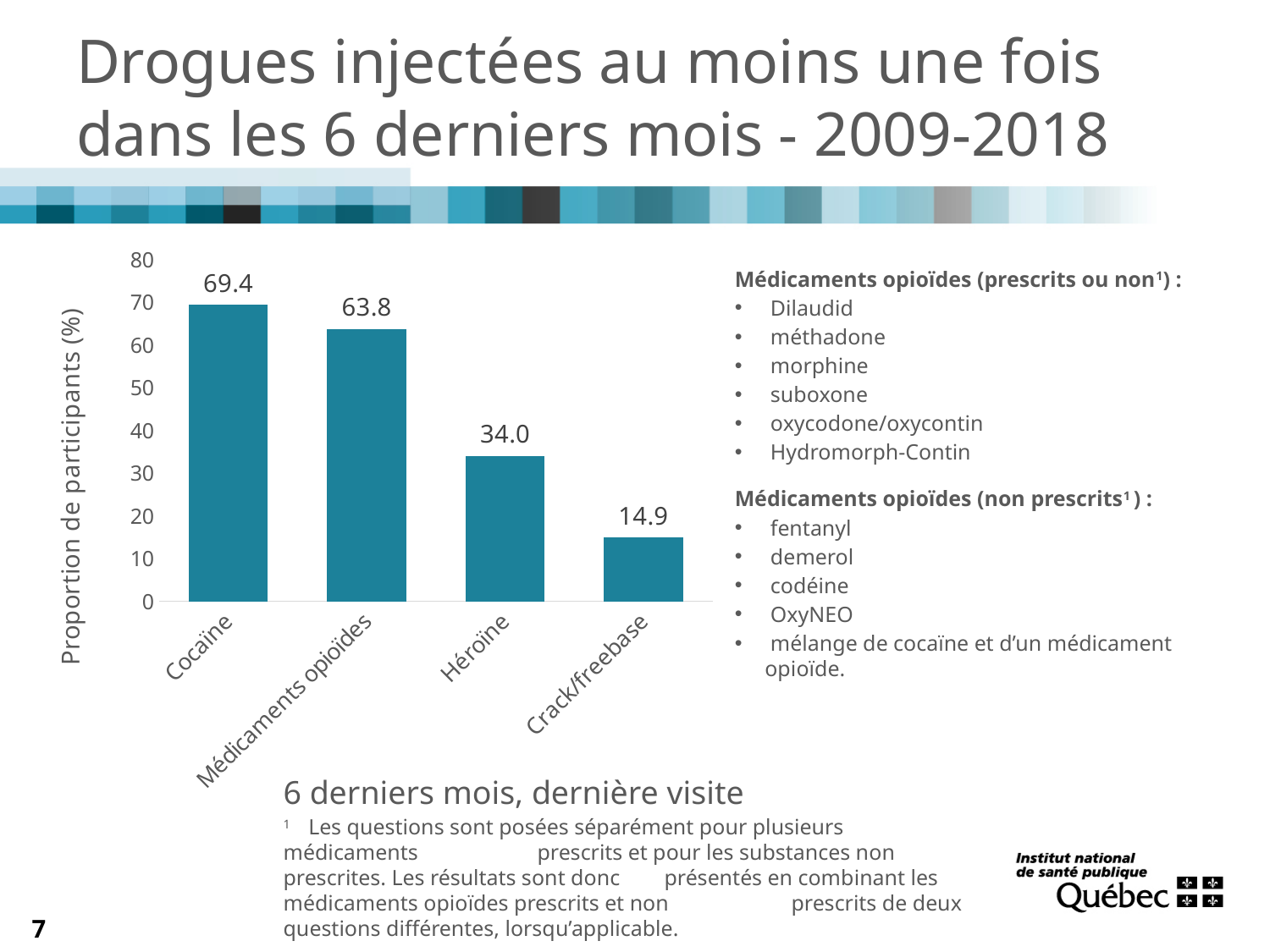
Which is larger, the value for Héroïne or the value for Crack/freebase? Héroïne What is the label of the vertical axis of the chart? Proportion de participants (%) What kind of chart is shown on the slide? Bar chart What is the difference between the values for Héroïne and Crack/freebase? 19.1 Which category has the lowest value? Crack/freebase What is the difference between the values for Cocaïne and Médicaments opioïdes? 5.6 How many categories are shown in the chart? 4 What is the value for Médicaments opioïdes? 63.8 What is the value for Crack/freebase? 14.9 What is the value for Héroïne? 34.0 Which category has the highest value? Cocaïne What is the value for Cocaïne? 69.4